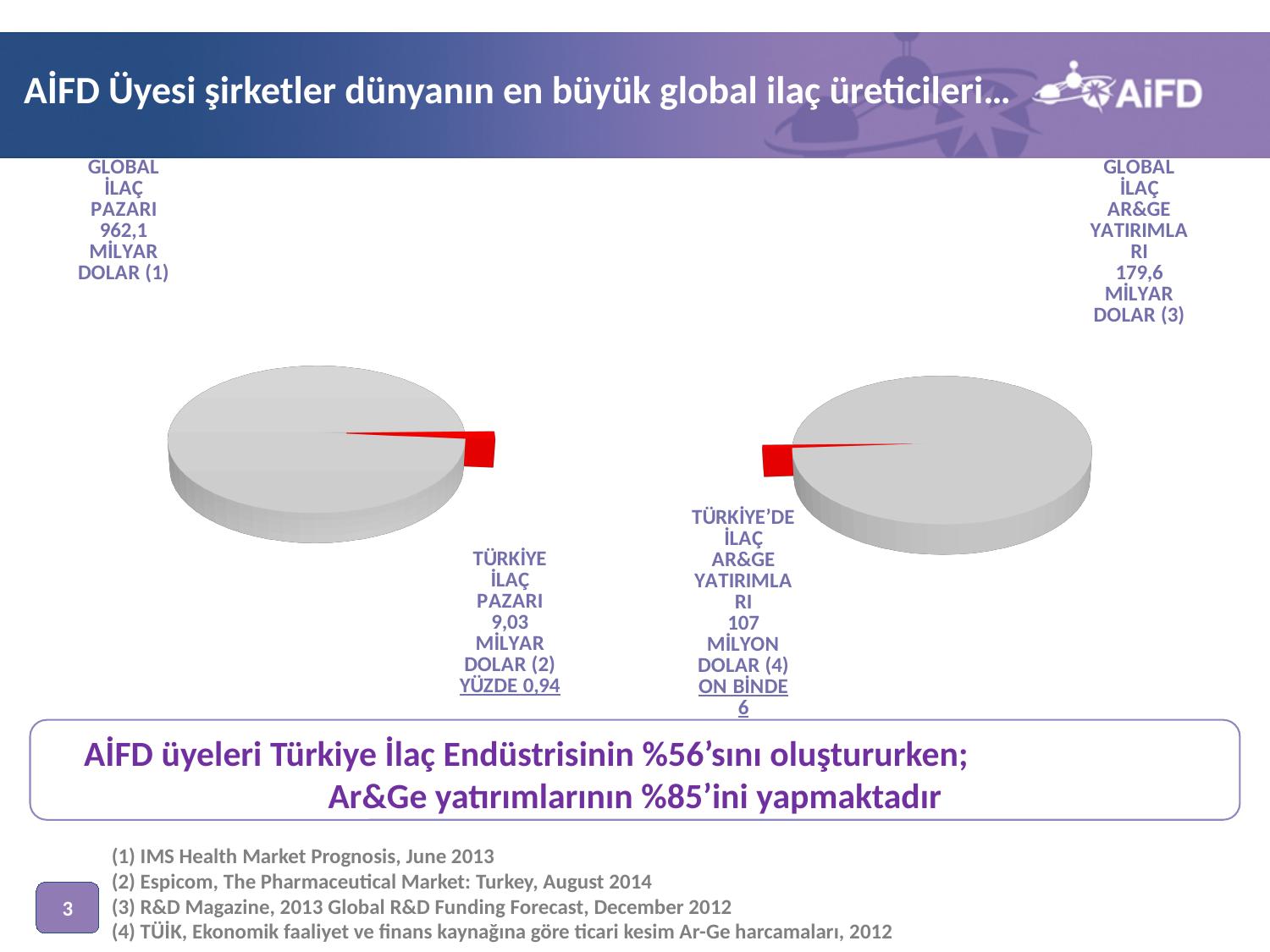
In the left pie chart, what share of the global pharmaceutical market does Turkey's market represent, as printed on the slide? YÜZDE 0,94 In the right pie chart, what share of global pharmaceutical R&D investment does Turkey's R&D investment represent, as printed on the slide? ON BİNDE 6 In the left pie chart, what value is given for GLOBAL İLAÇ PAZARI? 962,1 MİLYAR DOLAR In the left pie chart, what value is given for TÜRKİYE İLAÇ PAZARI? 9,03 MİLYAR DOLAR How many pie charts are on the slide? 2 What kind of chart is shown on the left side of the slide? Pie chart What colour is the slice representing Turkey in both pie charts? Red In the right pie chart, what value is given for GLOBAL İLAÇ AR&GE YATIRIMLARI? 179,6 MİLYAR DOLAR In the right pie chart, what value is given for TÜRKİYE'DE İLAÇ AR&GE YATIRIMLARI? 107 MİLYON DOLAR In the left pie chart, which slice is larger: GLOBAL İLAÇ PAZARI or TÜRKİYE İLAÇ PAZARI? GLOBAL İLAÇ PAZARI How many slices does each pie chart on the slide have? 2 In the right pie chart, which slice is smaller: GLOBAL İLAÇ AR&GE YATIRIMLARI or TÜRKİYE'DE İLAÇ AR&GE YATIRIMLARI? TÜRKİYE'DE İLAÇ AR&GE YATIRIMLARI